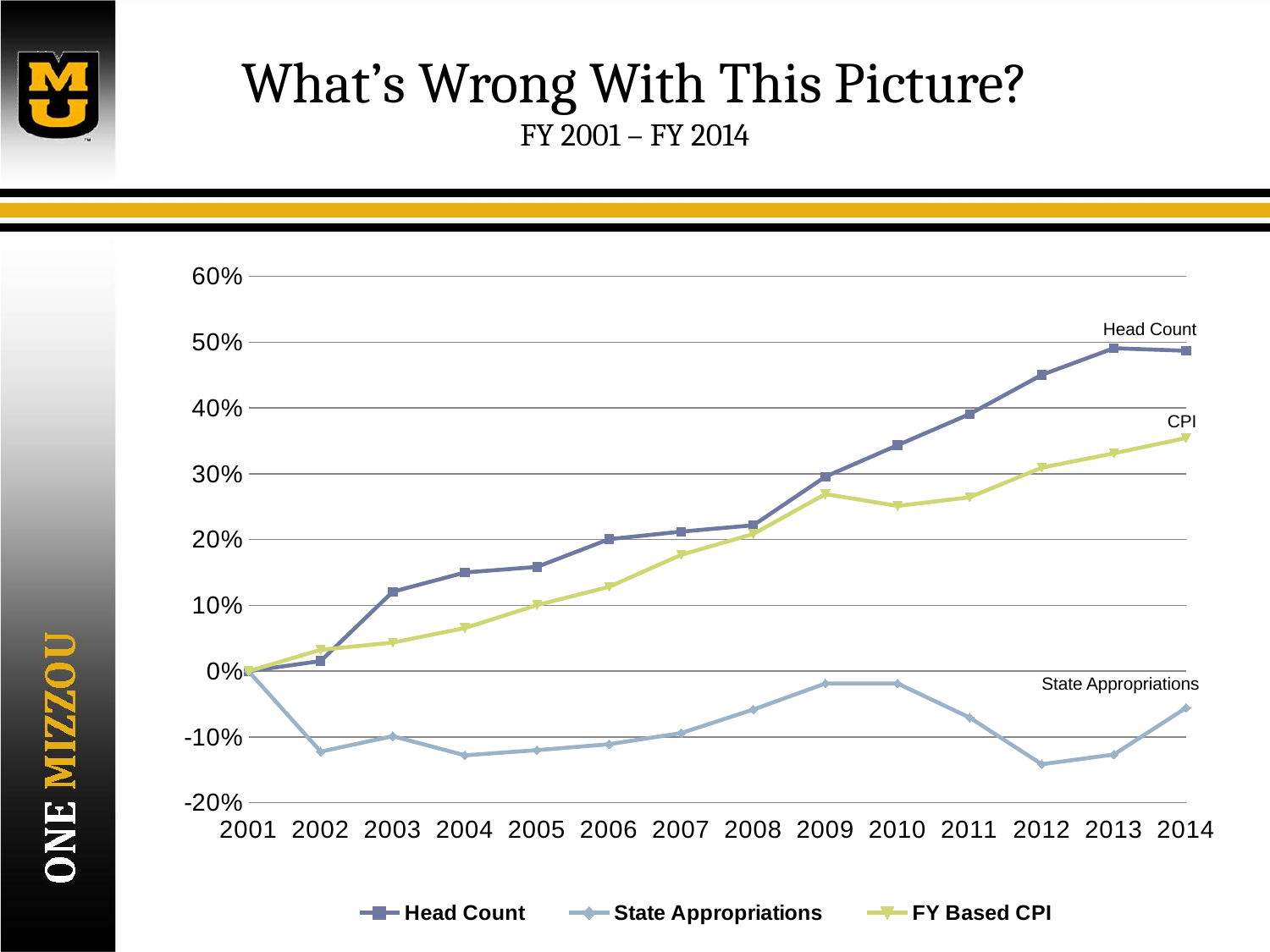
What kind of chart is shown on the slide? line chart Is the Head Count value for 2003 greater or less than 10%? greater What are the three series named in the legend? Head Count, State Appropriations, FY Based CPI Which series has the highest value in 2014? Head Count Is the State Appropriations value for 2012 greater or less than -10%? less How many years are plotted along the x axis? 14 In 2014, which series has the larger value: Head Count or FY Based CPI? Head Count Is the FY Based CPI value for 2014 greater or less than 30%? greater In which year is the State Appropriations value lowest? 2012 How many series does the legend list? 3 Does the Head Count series rise or fall from 2001 to 2013? rise